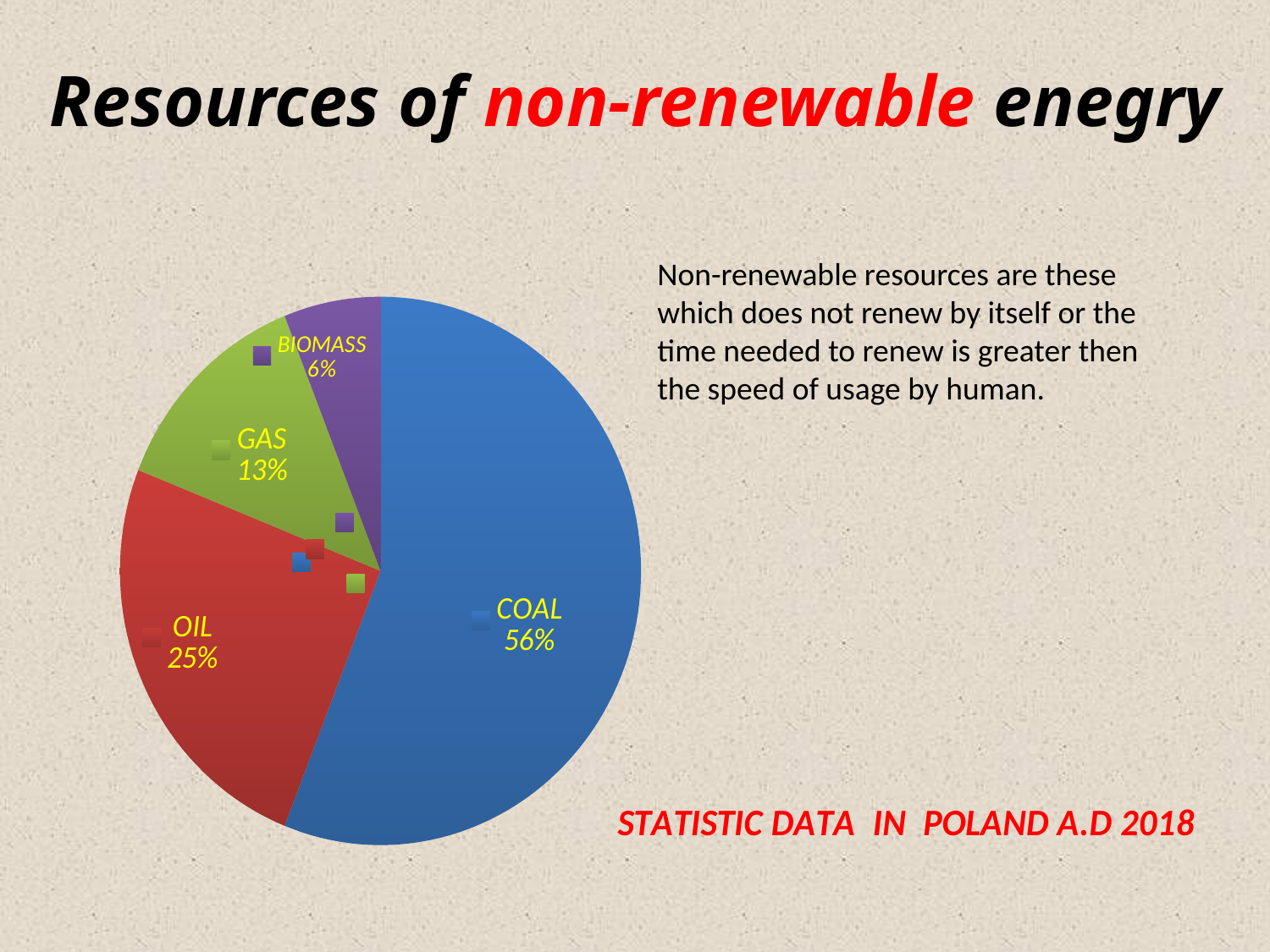
What kind of chart is shown on the slide? Pie chart What share of the pie does BIOMASS have? 6% What colour is the COAL slice? Blue Which category has the smallest slice of the pie? BIOMASS Which category has the largest slice of the pie? COAL What is the difference in percentage points between GAS and BIOMASS? 7 How many slices does the pie chart have? 4 What share of the pie does COAL have? 56% What share of the pie does OIL have? 25% What share of the pie does GAS have? 13% Which is larger, the share for OIL or the share for GAS? OIL What is the difference in percentage points between COAL and OIL? 31